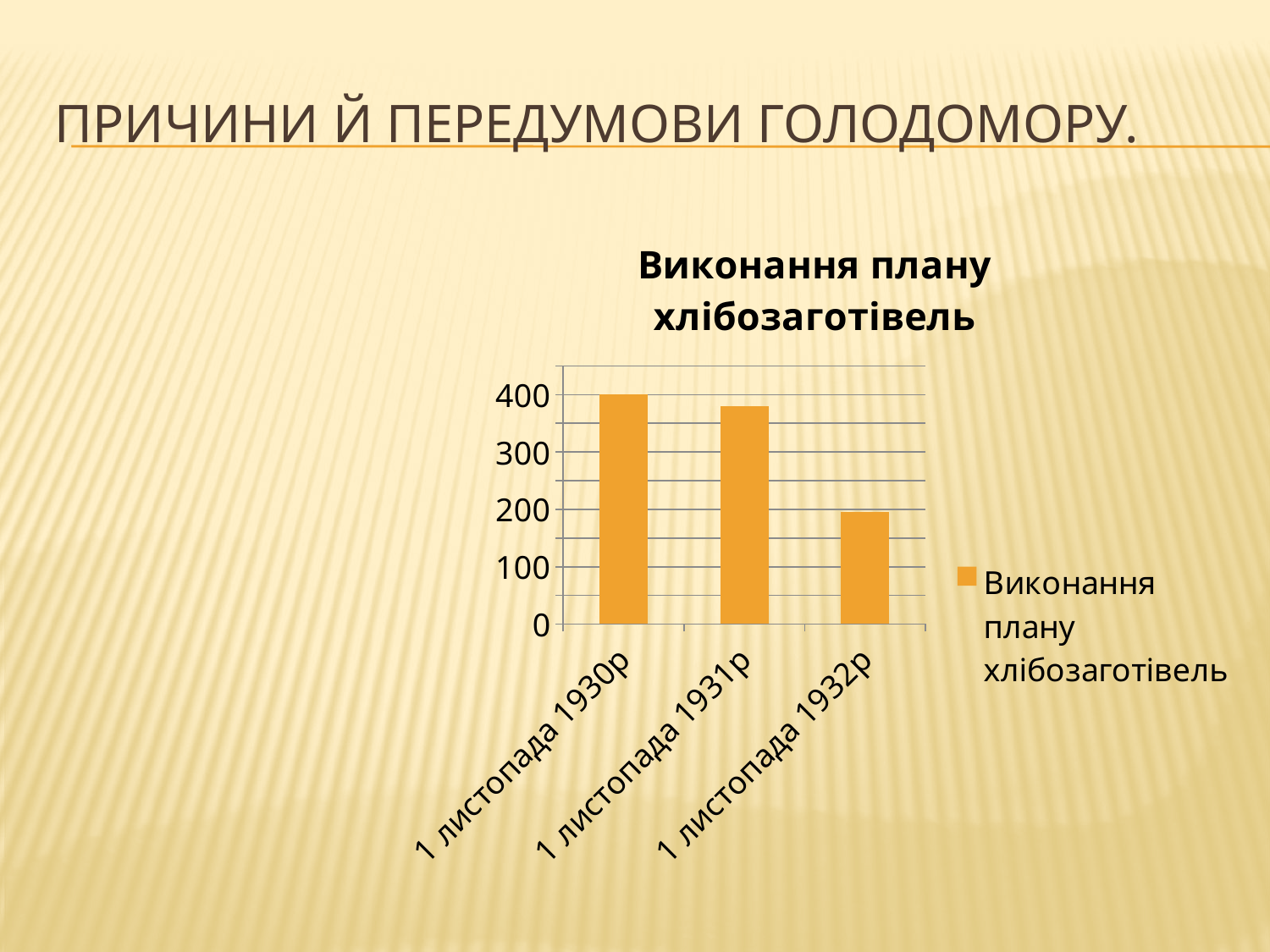
Which is larger, the value for 1 листопада 1931р or for 1 листопада 1932р? 1 листопада 1931р Which category has the lowest value? 1 листопада 1932р How many series does the legend list? 1 Is the value for 1 листопада 1932р greater or less than 300? less What kind of chart is shown on the slide? bar chart Which category has the highest value? 1 листопада 1930р What is the title of the chart? Виконання плану хлібозаготівель How many categories are plotted on the x axis? 3 Is the value for 1 листопада 1932р greater or less than 100? greater Do the values rise or fall from 1 листопада 1930р to 1 листопада 1932р? fall What is the name of the series shown in the legend? Виконання плану хлібозаготівель Is the value for 1 листопада 1931р greater or less than 300? greater